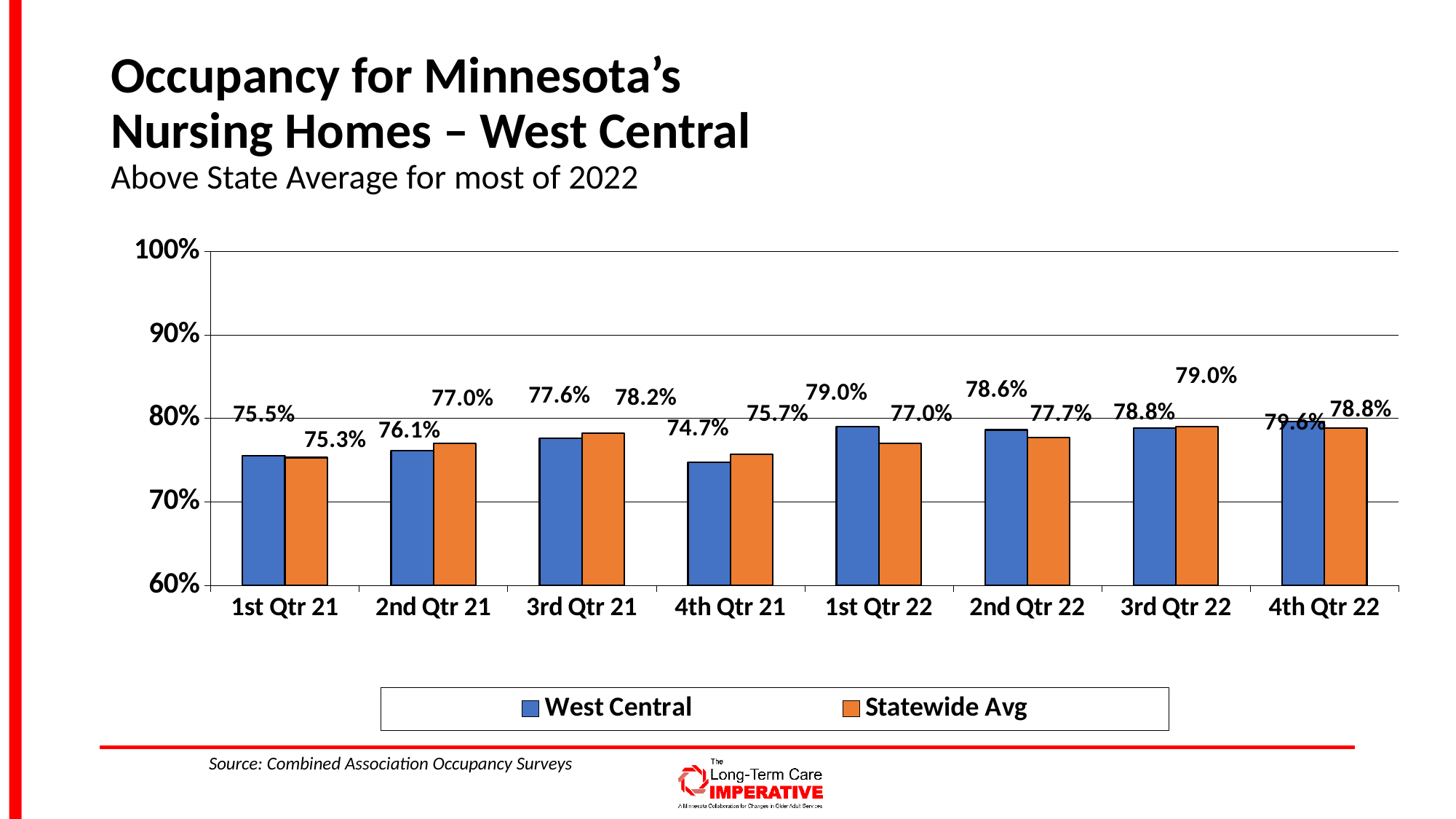
What kind of chart is shown on the slide? Bar chart In which quarter is the Statewide Avg occupancy highest? 3rd Qtr 22 Which is larger in 2nd Qtr 21, West Central or Statewide Avg? Statewide Avg What is the Statewide Avg occupancy value for 3rd Qtr 21? 78.2% In which quarter is the Statewide Avg occupancy lowest? 1st Qtr 21 What is the West Central occupancy value for 1st Qtr 22? 79.0% What is the West Central occupancy value for 4th Qtr 21? 74.7% How many series does the legend list? 2 What is the difference between the West Central and Statewide Avg values in 1st Qtr 22? 2.0 percentage points In which quarter is the West Central occupancy lowest? 4th Qtr 21 What is the Statewide Avg occupancy value for 2nd Qtr 22? 77.7% How many quarters are shown on the x axis? 8